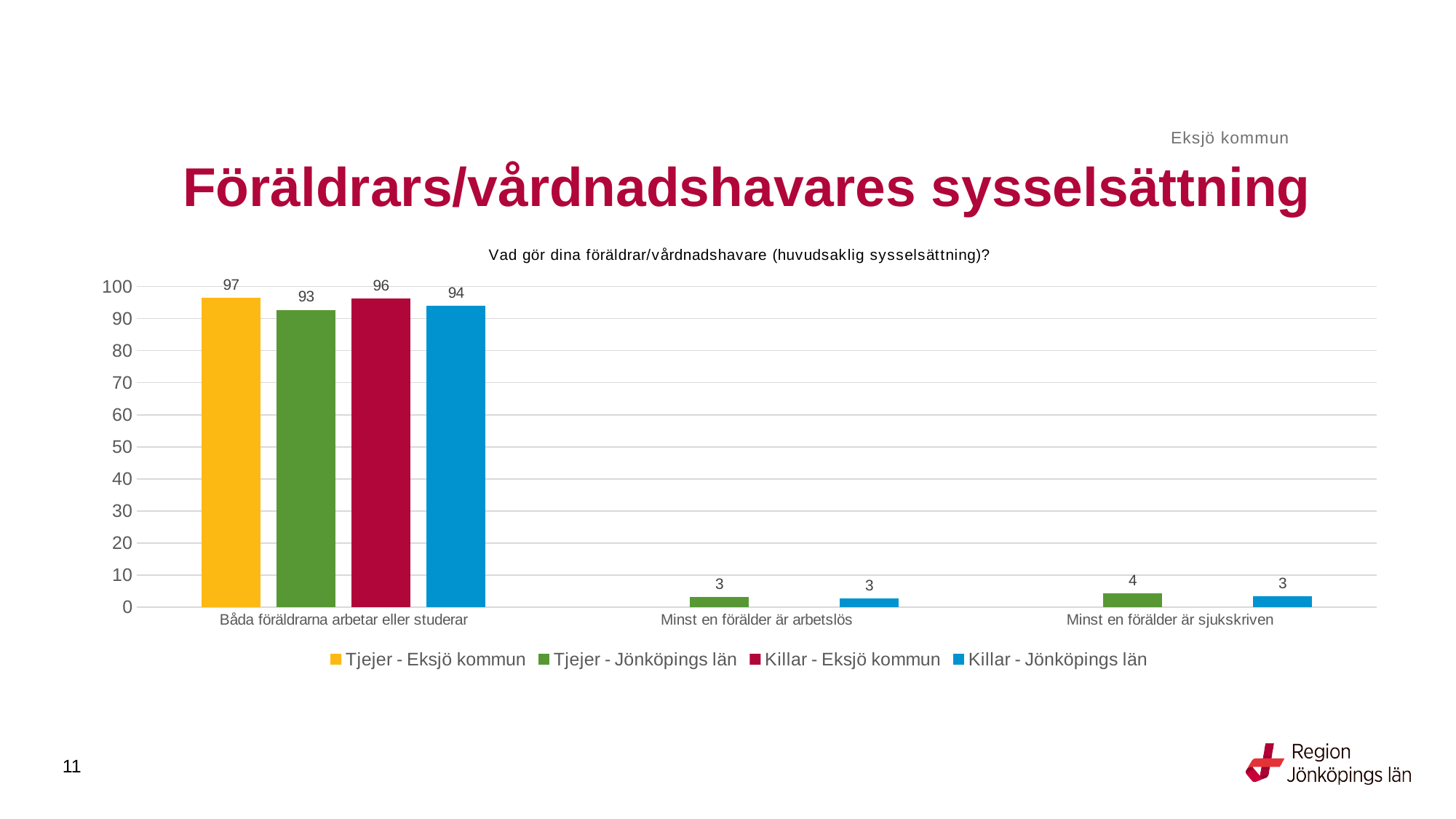
What is the value for Tjejer - Eksjö kommun in the category 'Båda föräldrarna arbetar eller studerar'? 97 Which series has the highest value in the category 'Båda föräldrarna arbetar eller studerar'? Tjejer - Eksjö kommun Which series has the lowest value in the category 'Båda föräldrarna arbetar eller studerar'? Tjejer - Jönköpings län What is the difference between Tjejer - Eksjö kommun and Tjejer - Jönköpings län in the category 'Båda föräldrarna arbetar eller studerar'? 4 What is the value for Killar - Jönköpings län in the category 'Minst en förälder är sjukskriven'? 3 What kind of chart is shown on the slide? bar chart Is the value for Killar - Jönköpings län in 'Båda föräldrarna arbetar eller studerar' greater or less than 90? greater What colour represents Killar - Eksjö kommun in the chart? red How many categories are shown on the x axis? 3 How many series does the legend list? 4 Which is larger in the category 'Båda föräldrarna arbetar eller studerar': Killar - Eksjö kommun or Killar - Jönköpings län? Killar - Eksjö kommun What is the value for Tjejer - Jönköpings län in the category 'Minst en förälder är arbetslös'? 3